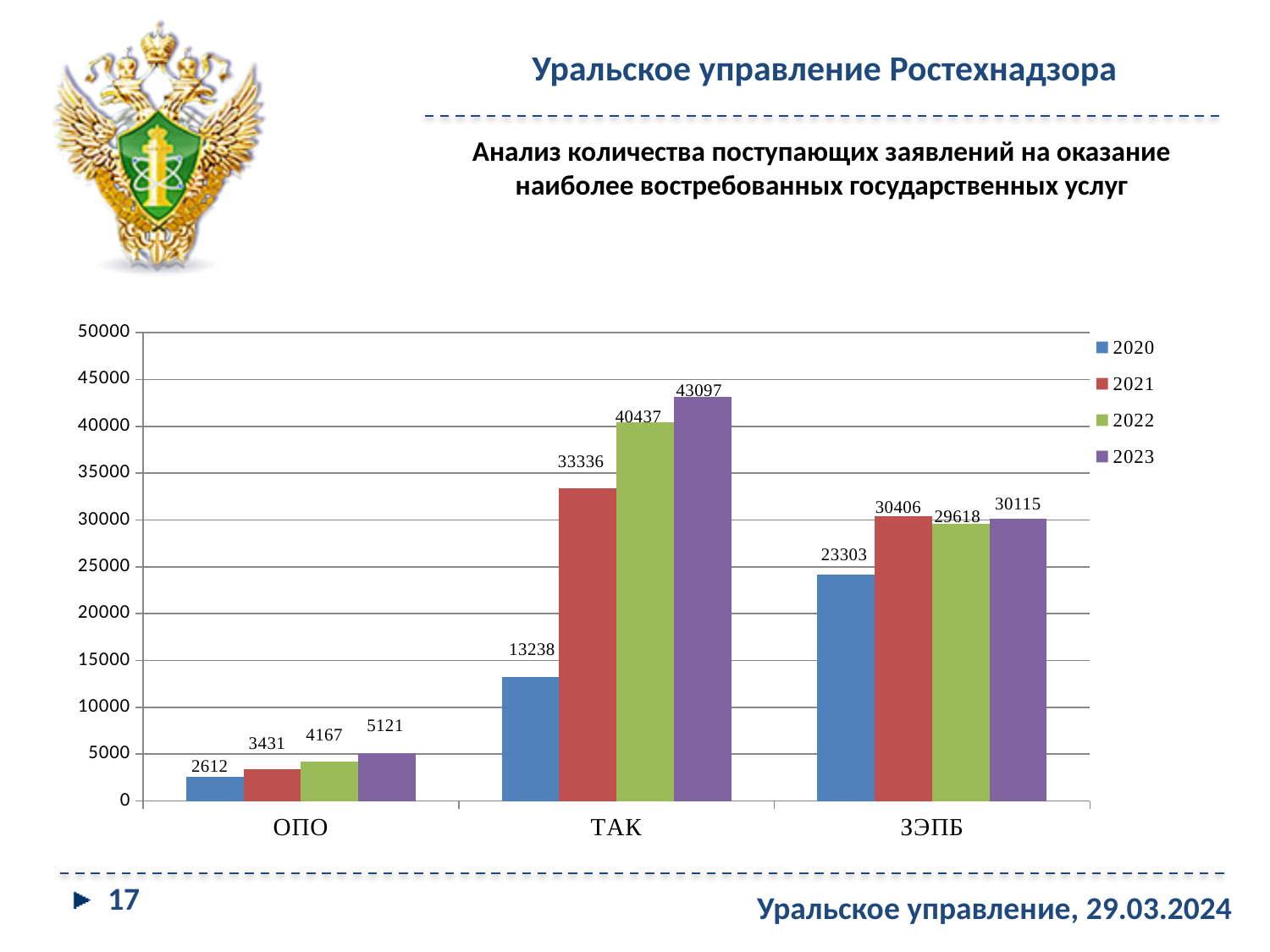
Which category has the lowest value in 2023? ОПО Which category has the highest value in 2021? ТАК How many series does the legend list? 4 What kind of chart is shown on the slide? bar chart What is the difference between the 2023 and 2020 values for ТАК? 29859 Which is larger for ЗЭПБ: the 2021 value or the 2022 value? 2021 Do the values for ОПО rise or fall from 2020 to 2023? rise What is the value for ЗЭПБ in 2022? 29618 What is the value for ТАК in 2023? 43097 Is the value for ЗЭПБ in 2020 greater or less than 25000? less How many categories are shown on the x axis? 3 What is the value for ОПО in 2020? 2612